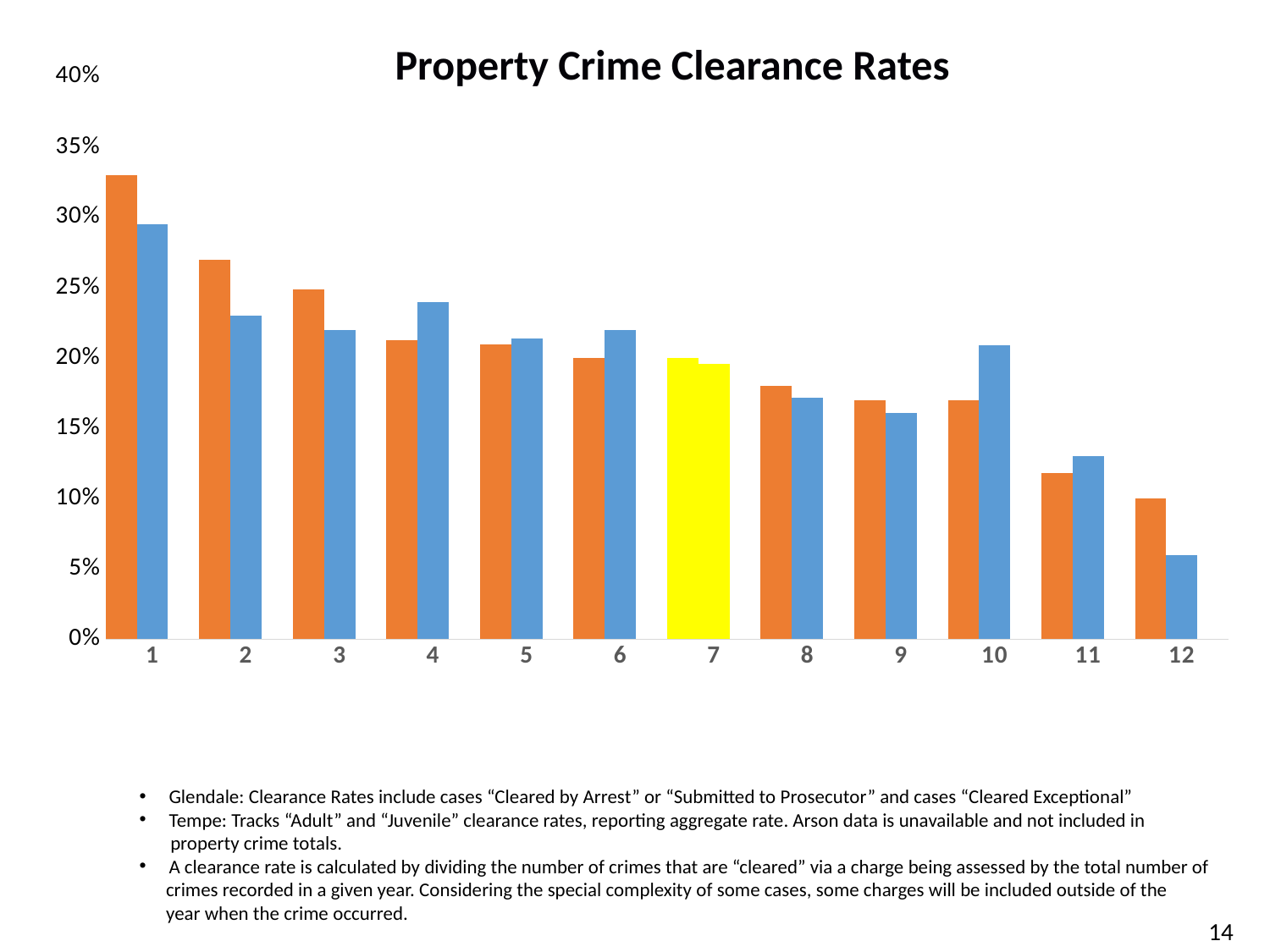
Which category has the shortest orange bar? 12 What type of chart is shown on the slide? bar chart Is the blue bar for category 12 greater or less than 10%? less For category 2, which bar is taller, the orange one or the blue one? orange Do the orange bars generally rise or fall from category 1 to category 12? fall Is the orange bar for category 1 greater or less than 30%? greater How many categories are shown along the x axis of the chart? 12 Which category has the shortest blue bar? 12 What is the title of the chart? Property Crime Clearance Rates For category 4, which bar is taller, the orange one or the blue one? blue Is the blue bar for category 10 greater or less than 20%? greater Which category has the tallest orange bar? 1